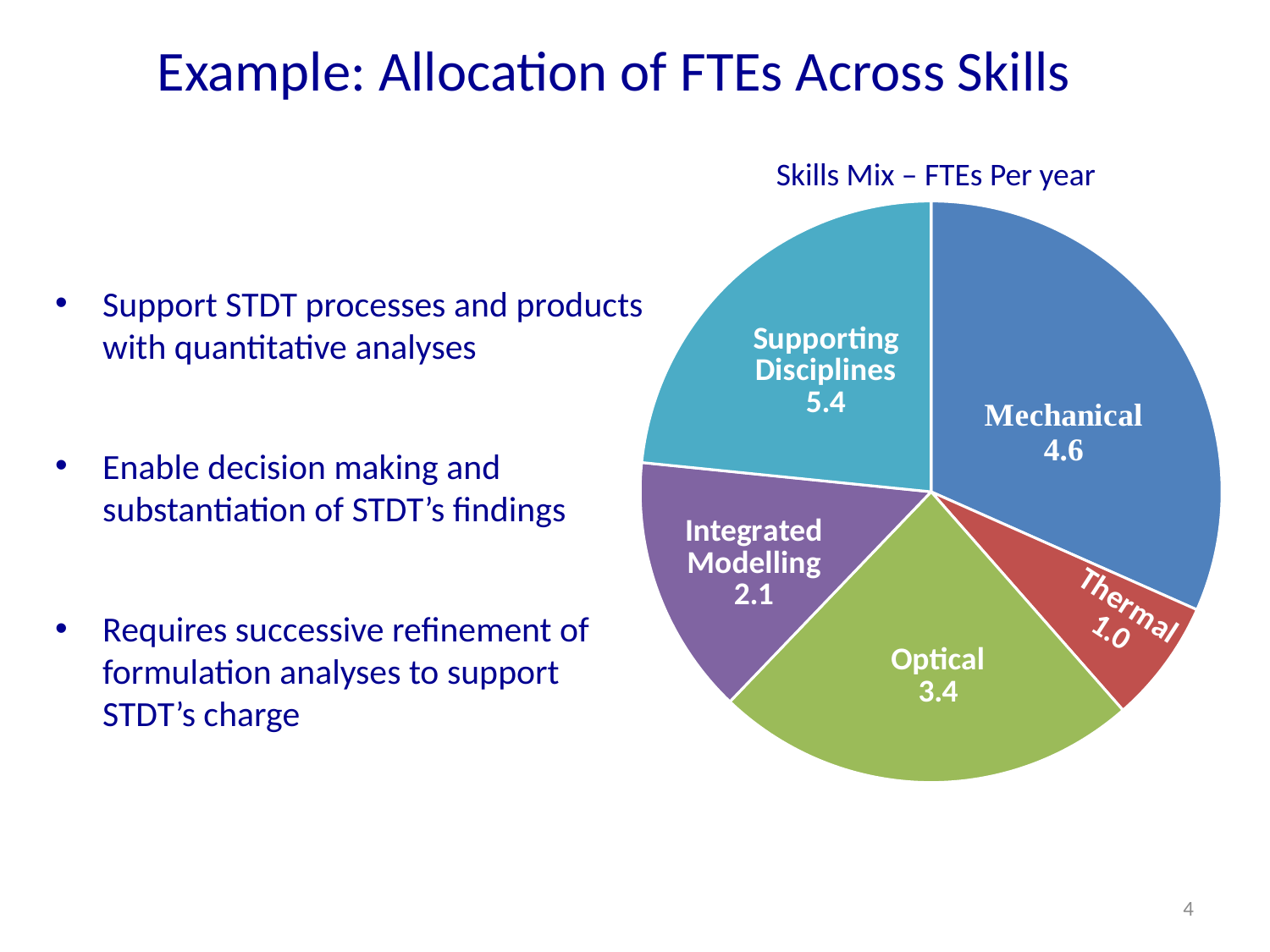
How many FTEs per year are allocated to Supporting Disciplines? 5.4 How many FTEs per year are allocated to Integrated Modelling? 2.1 How many skill categories are shown in the pie chart? 5 What is the title of the chart? Skills Mix – FTEs Per year What kind of chart is shown on the slide? Pie chart How many FTEs per year are allocated to Mechanical? 4.6 How many FTEs per year are allocated to Thermal? 1.0 Which skill has the smallest share of FTEs? Thermal What is the difference in FTEs between Supporting Disciplines and Mechanical? 0.8 What is the total number of FTEs per year across all skills in the chart? 16.5 Which has more FTEs, Optical or Integrated Modelling? Optical